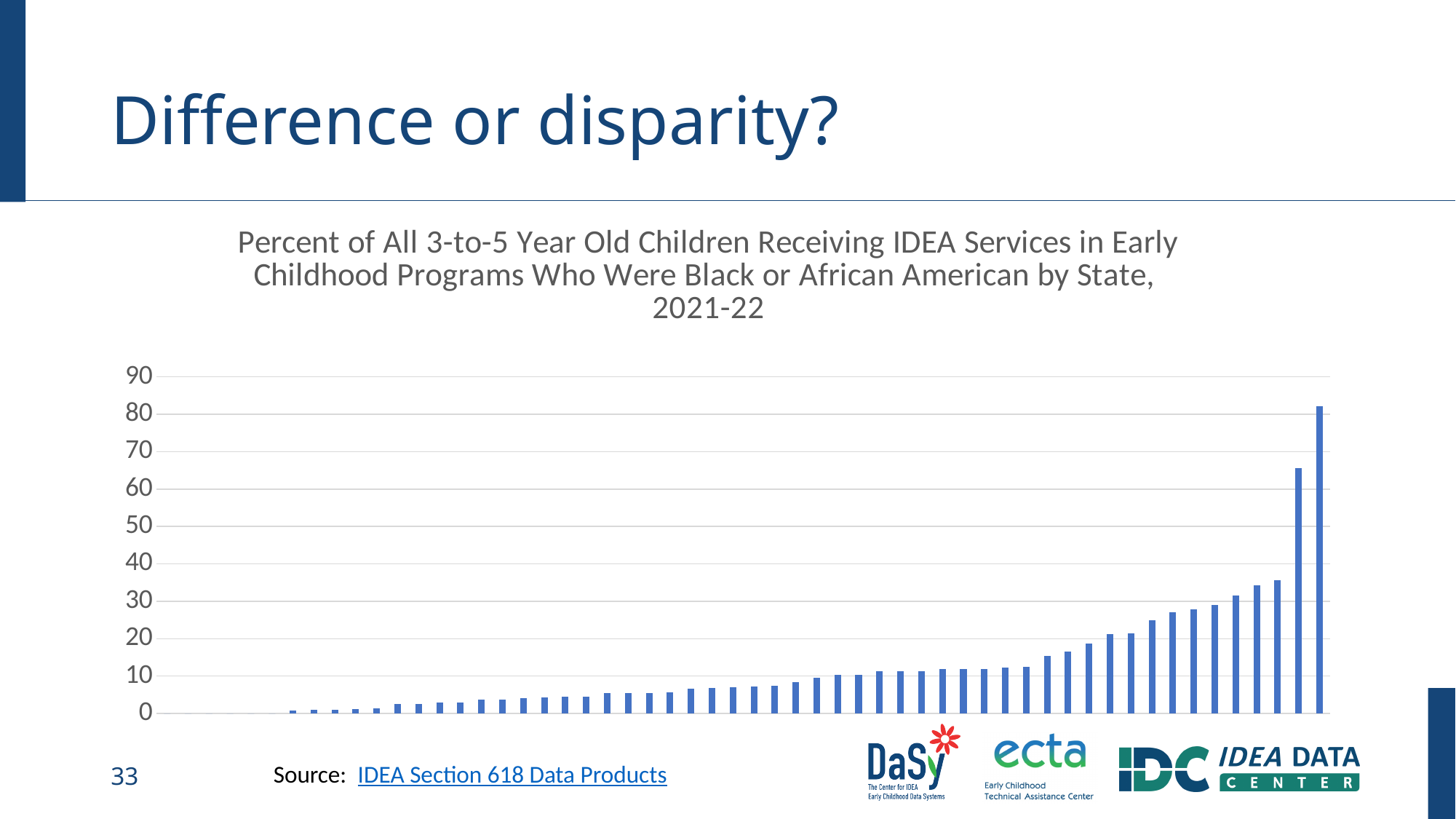
Is the rightmost bar taller or shorter than the bar immediately to its left? taller Is the value of the second tallest bar greater or less than 70? less Do the bar values rise or fall from left to right along the x axis? rise What is the title of the chart? Percent of All 3-to-5 Year Old Children Receiving IDEA Services in Early Childhood Programs Who Were Black or African American by State, 2021-22 Is the value of the third tallest bar greater or less than 30? greater What is the highest value shown on the vertical axis? 90 Is the value of the tallest bar greater or less than 80? greater What kind of chart is shown on the slide? bar chart